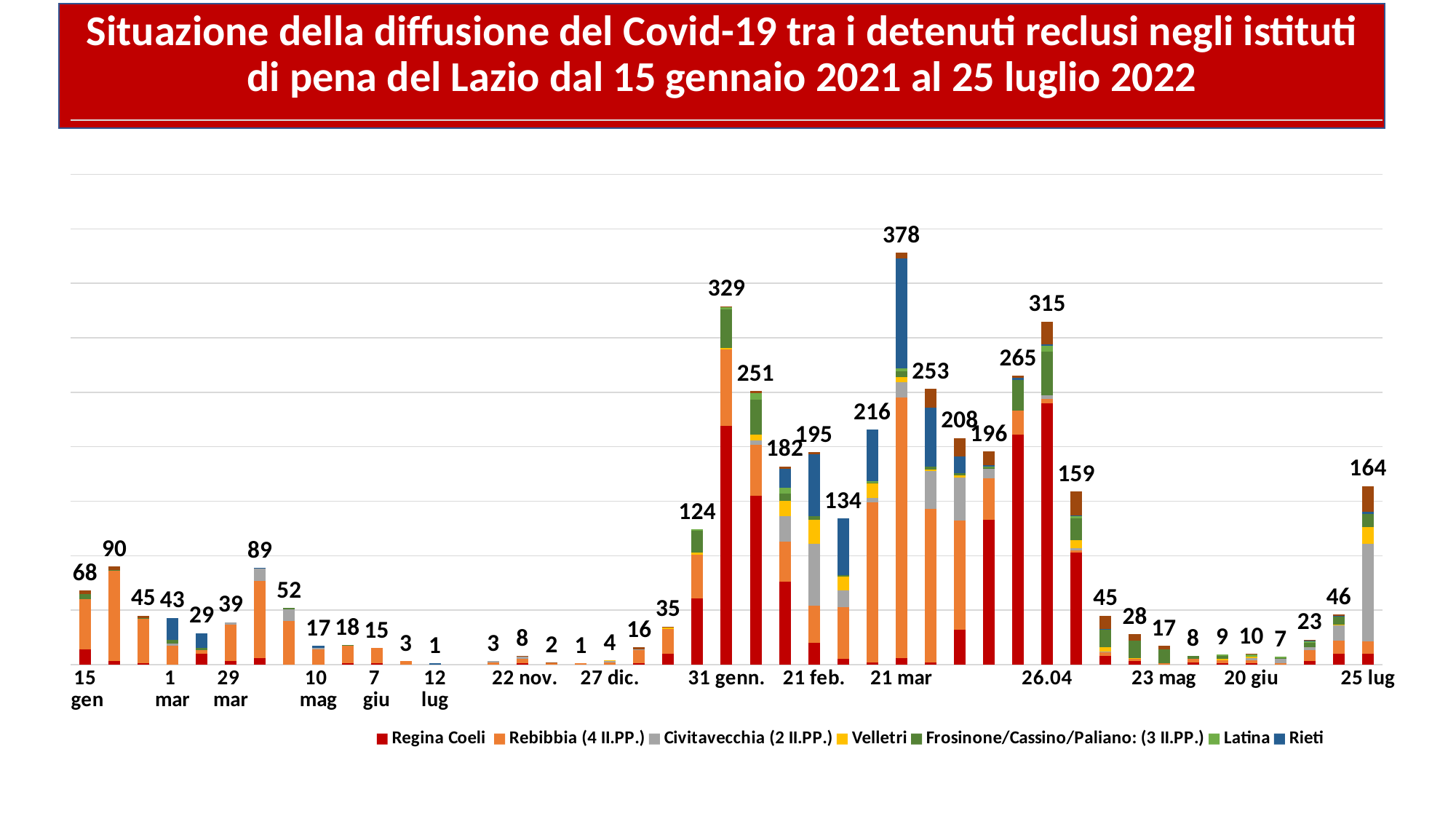
What is the total value shown for 25 lug? 164 What kind of chart is shown on the slide? stacked bar chart Which has the larger total, 26.04 or 31 genn.? 31 genn. What is the total value shown for 21 mar? 378 What is the total value shown for 26.04? 315 Which date has the highest total on the chart? 21 mar What is the total value shown for 12 lug? 1 How many series does the legend list? 7 What colour represents Regina Coeli in the legend? red What is the total value shown for 31 genn.? 329 What is the total value shown for 15 gen? 68 What is the difference between the totals for 21 mar and 31 genn.? 49